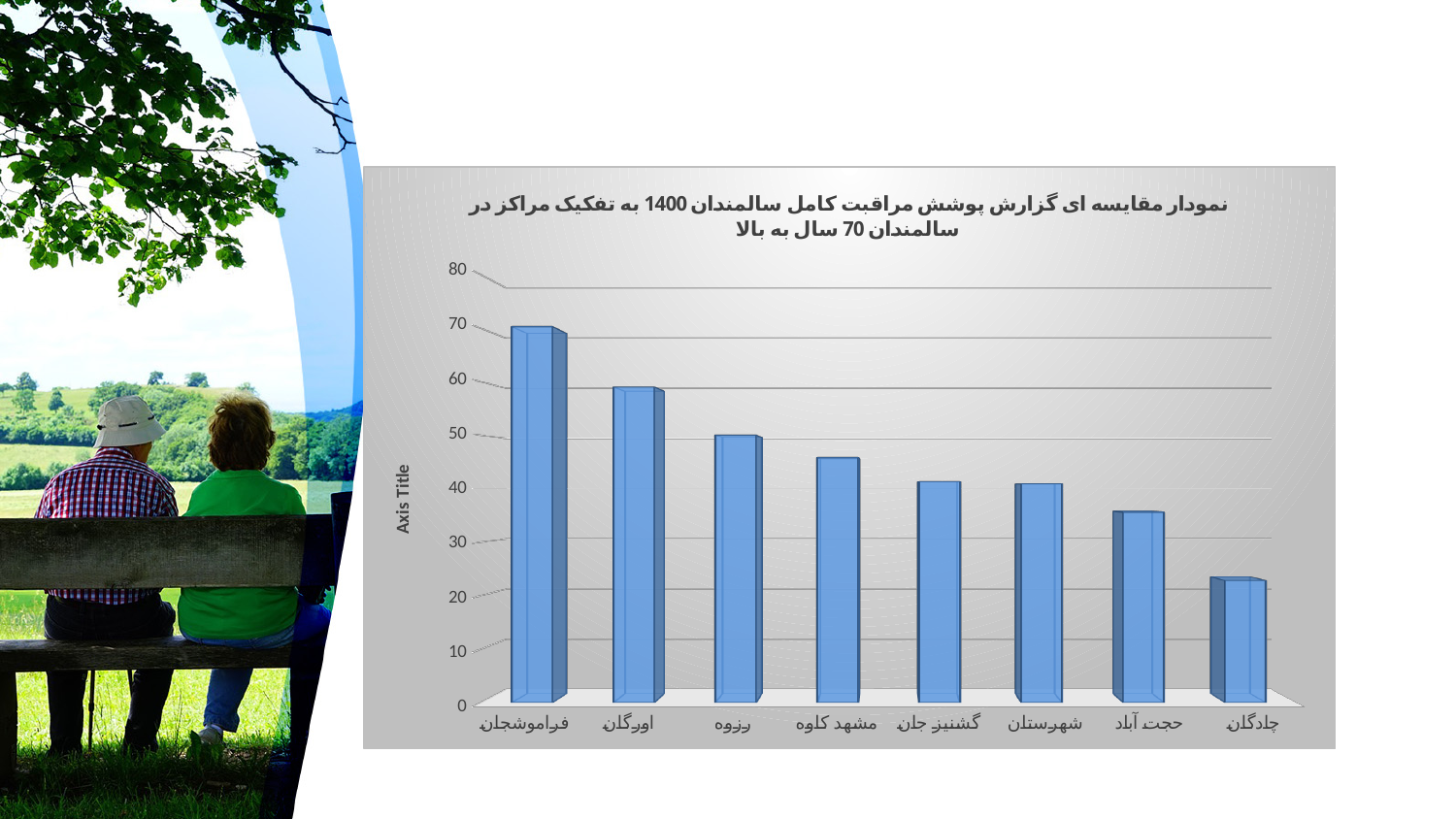
Is the value for فراموشجان greater or less than 60? greater Is the value for چادگان greater or less than 30? less Is the value for حجت آباد greater or less than 40? less Which centre has the highest bar in the chart? فراموشجان How many categories (centres) are shown on the x axis of the chart? 8 What kind of chart is shown on the slide? bar chart Which centre has the lowest bar in the chart? چادگان What is the label shown on the vertical axis of the chart? Axis Title Do the bar values rise or fall moving from left to right along the x axis? fall What is the highest tick value shown on the vertical axis of the chart? 80